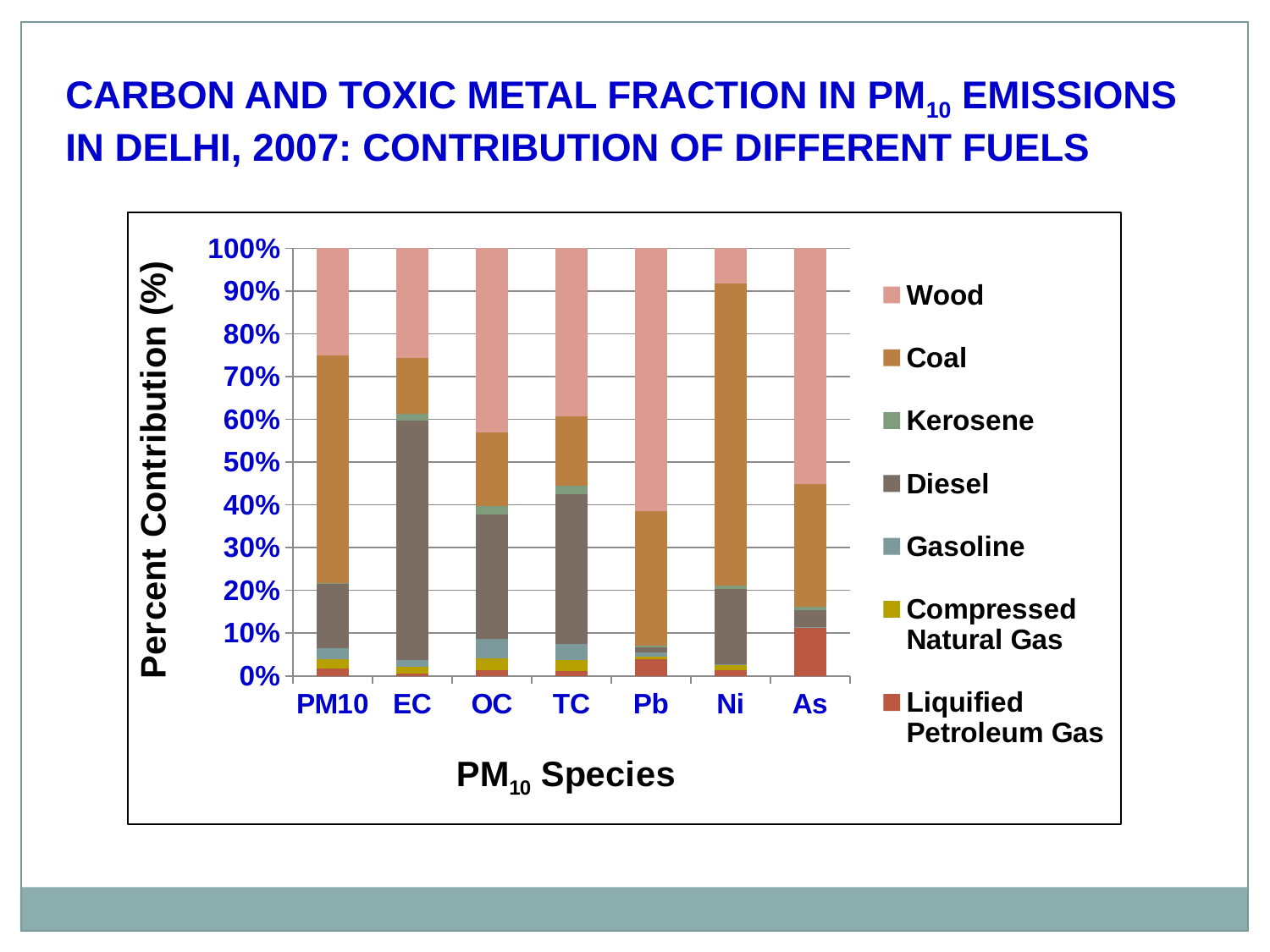
How many PM10 species (categories) are shown on the x axis? 7 Is the Wood contribution for Ni greater or less than 10%? less Which PM10 species has the smallest Wood contribution? Ni What is the label of the y axis? Percent Contribution (%) Is the Wood contribution for Pb greater or less than 50%? greater Which PM10 species has the largest Liquified Petroleum Gas contribution? As Is the Diesel contribution larger for EC or for As? EC Is the Coal contribution for Ni greater or less than 60%? greater What kind of chart is shown on the slide? Stacked bar chart Is the Coal contribution larger for Ni or for EC? Ni Which PM10 species has the largest Diesel contribution? EC How many fuel series does the legend list? 7